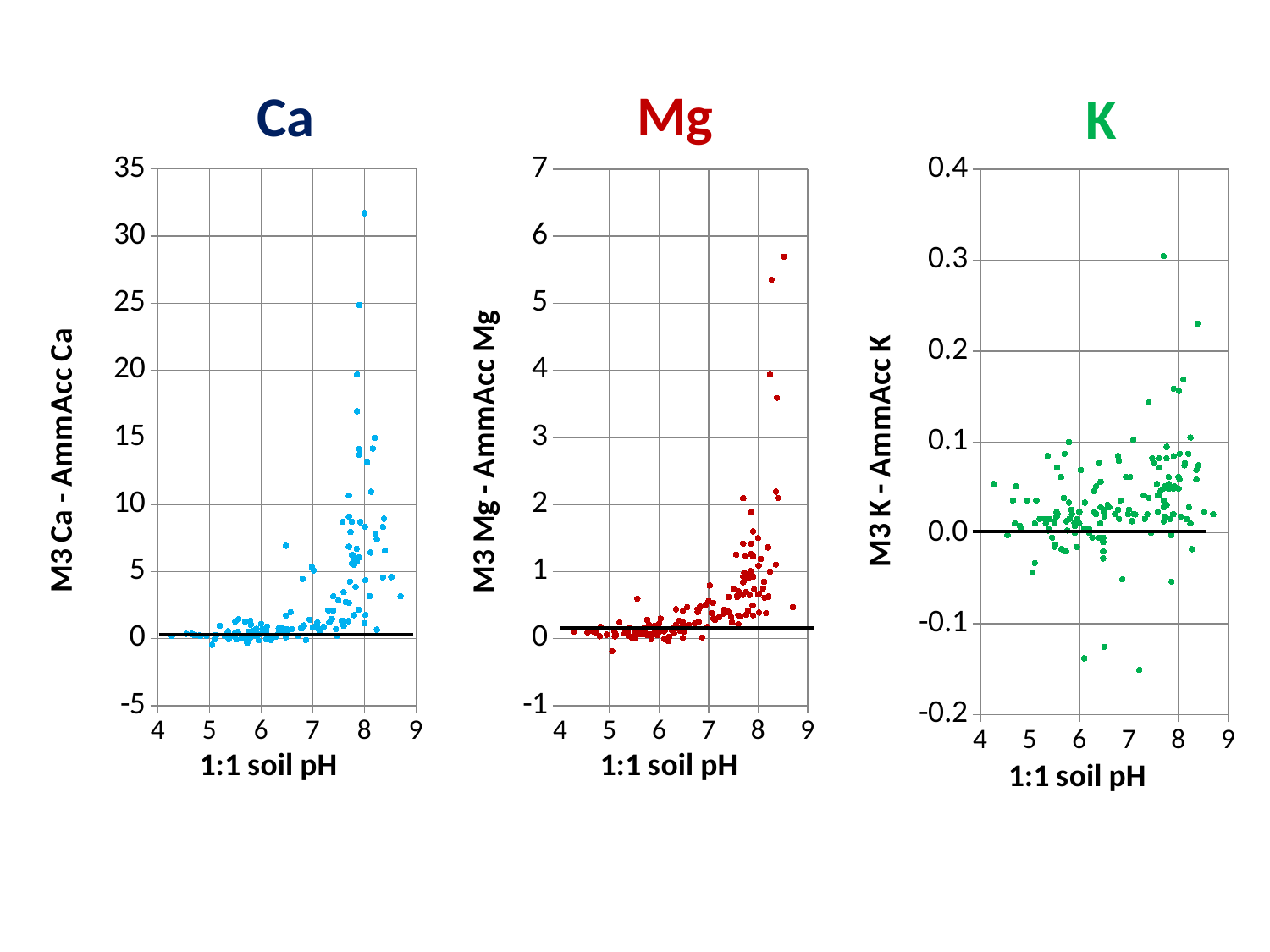
How many charts are shown on the slide? 3 What is the maximum value shown on the y-axis of the Ca chart? 35 In the Ca chart, is the highest plotted value greater or less than 30? greater In the Mg chart, do the plotted values generally rise or fall as soil pH increases? rise In the K chart, is the lowest plotted value greater or less than -0.1? less In the Mg chart, is the highest plotted value greater or less than 5? greater What is the y-axis title of the K chart? M3 K - AmmAcc K What kind of chart is the Ca chart? scatter plot Which chart has the highest plotted value: the Ca chart or the Mg chart? Ca What is the x-axis title of the Mg chart? 1:1 soil pH In the Ca chart, do the plotted values generally rise or fall as soil pH increases? rise